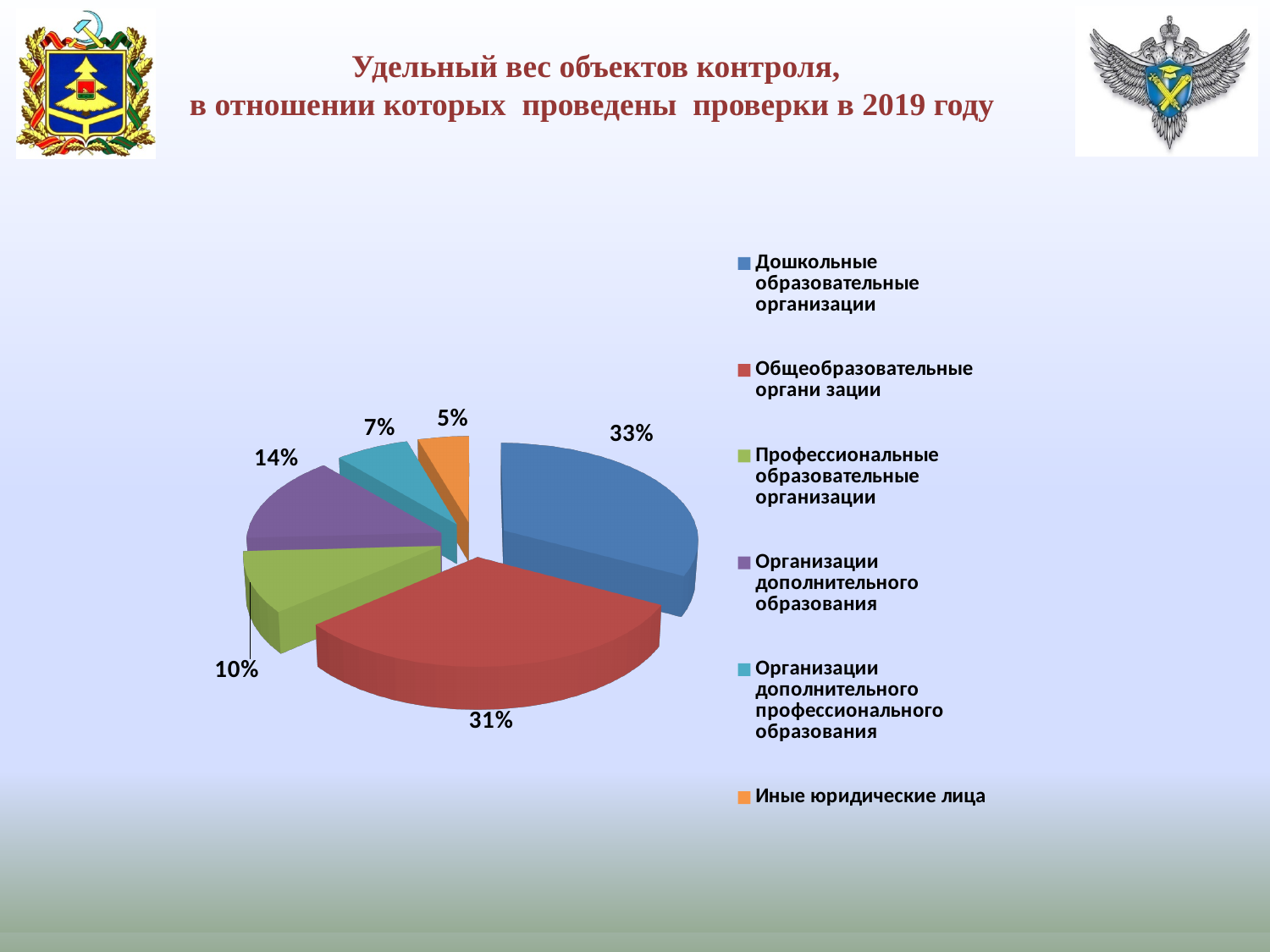
What is the difference in percentage points between the slices for Организации дополнительного образования and Организации дополнительного профессионального образования? 7 Which category has the largest slice of the pie? Дошкольные образовательные организации What share of the pie is labelled for Дошкольные образовательные организации? 33% What share of the pie is labelled for Профессиональные образовательные организации? 10% What share of the pie is labelled for Иные юридические лица? 5% Which slice is larger: Профессиональные образовательные организации or Организации дополнительного образования? Организации дополнительного образования What colour is the slice for Общеобразовательные организации? red How many slices does the pie chart have? 6 Which category has the smallest slice of the pie? Иные юридические лица What share of the pie is labelled for Общеобразовательные организации? 31% What share of the pie is labelled for Организации дополнительного образования? 14% What kind of chart is shown on the slide? pie chart